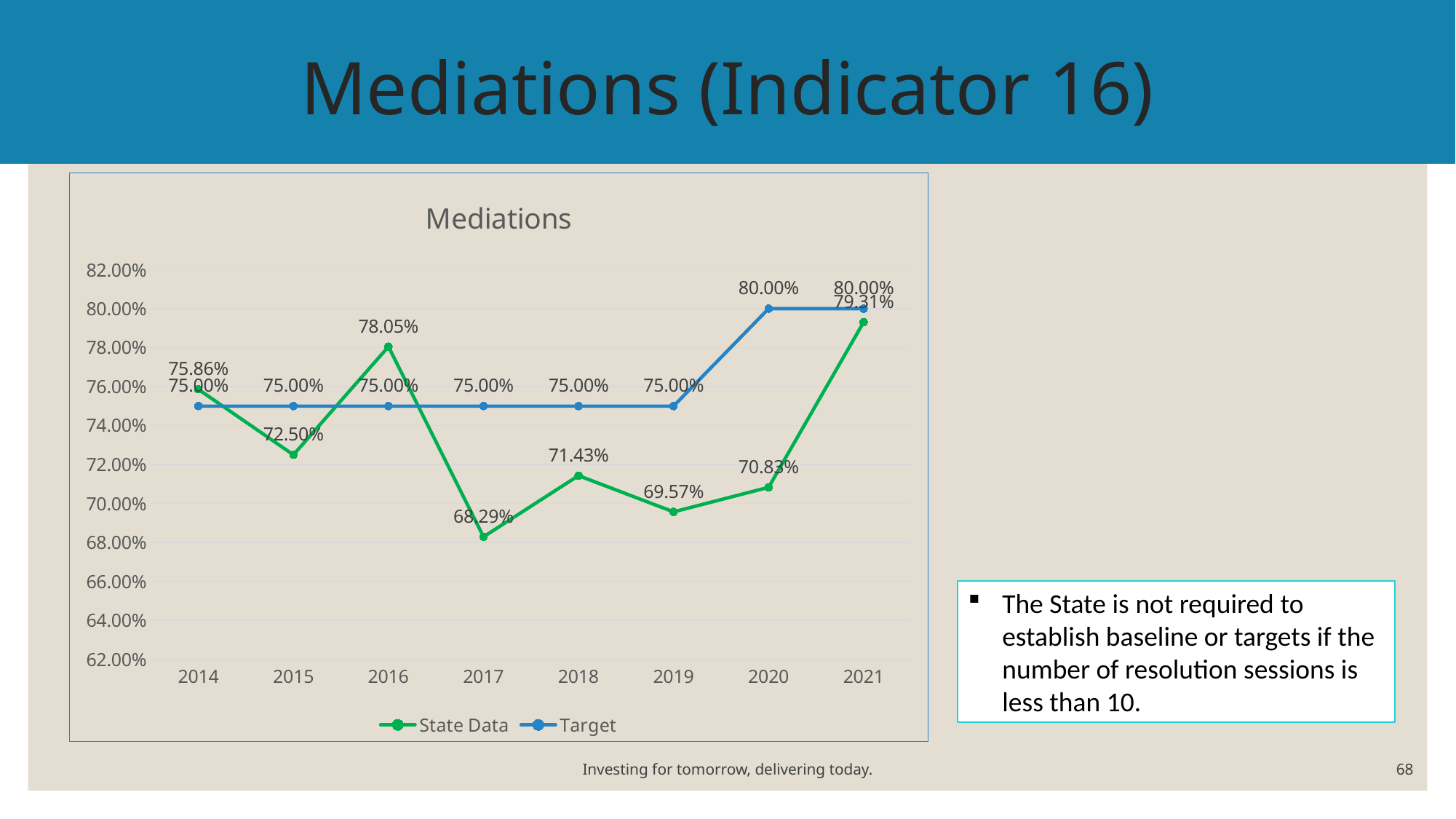
What is the Target value for 2020? 80.00% In which year is the State Data value lowest? 2017 What is the State Data value for 2021? 79.31% Does the State Data value rise or fall from 2019 to 2021? Rise What is the difference between the Target and State Data values in 2021? 0.69% What is the State Data value for 2017? 68.29% How many series does the legend list? 2 What type of chart is shown on the slide? Line chart What is the State Data value for 2016? 78.05% How many years are shown on the x axis? 8 Which is larger in 2014, the State Data value or the Target value? State Data In which year is the State Data value highest? 2021